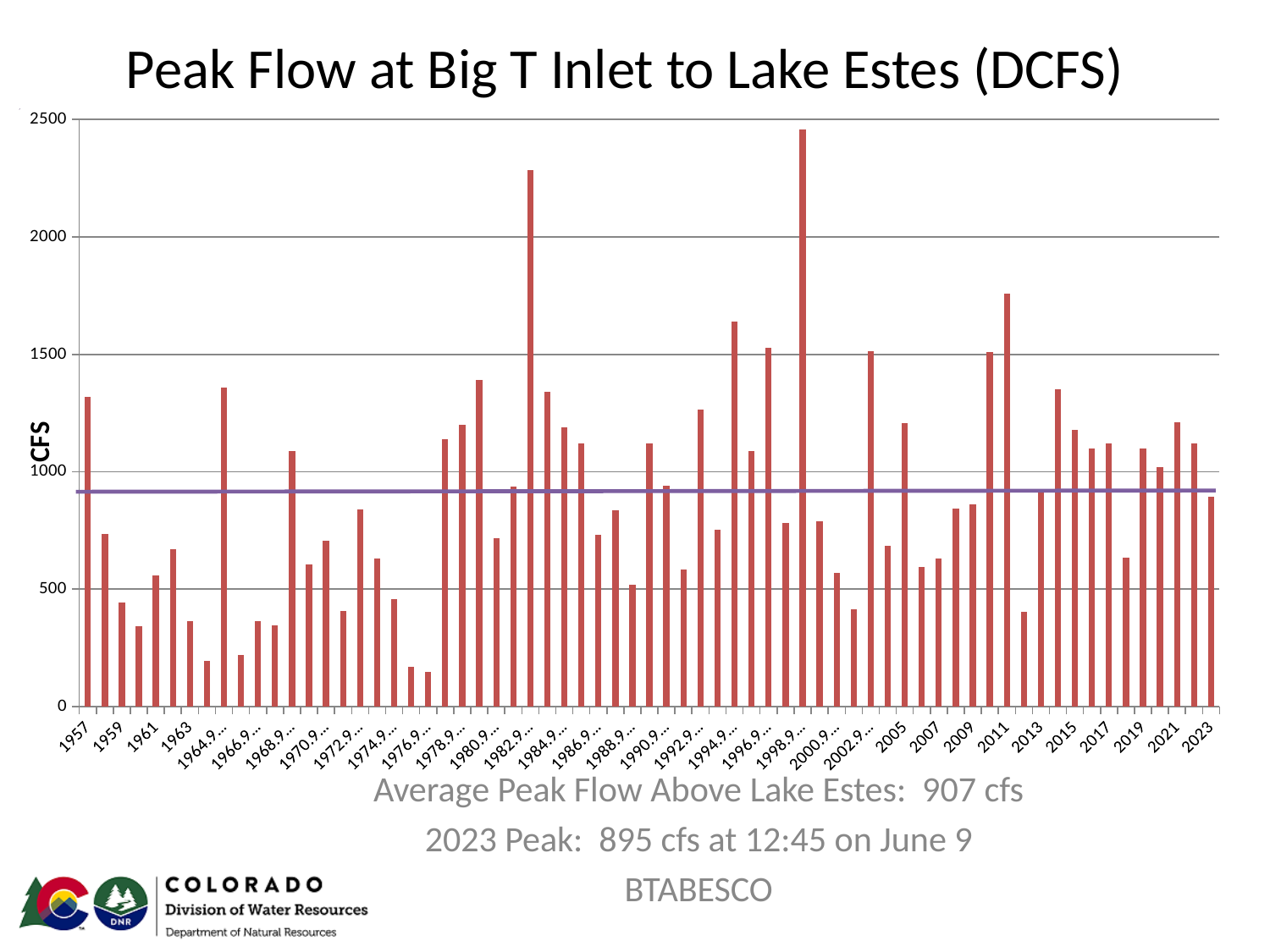
Is the value for 1957 greater or less than 1000? greater What is the average peak flow above Lake Estes stated on the slide? 907 cfs What is the title of the chart? Peak Flow at Big T Inlet to Lake Estes (DCFS) What is the label on the vertical axis of the chart? CFS What kind of chart is shown on the slide? bar chart Which year has the larger value, 2011 or 2013? 2011 Which year has the larger value, 1957 or 1959? 1957 Is the value for 2015 greater or less than 1000? greater What was the 2023 peak flow according to the slide? 895 cfs Is the value for 2019 greater or less than 1000? greater